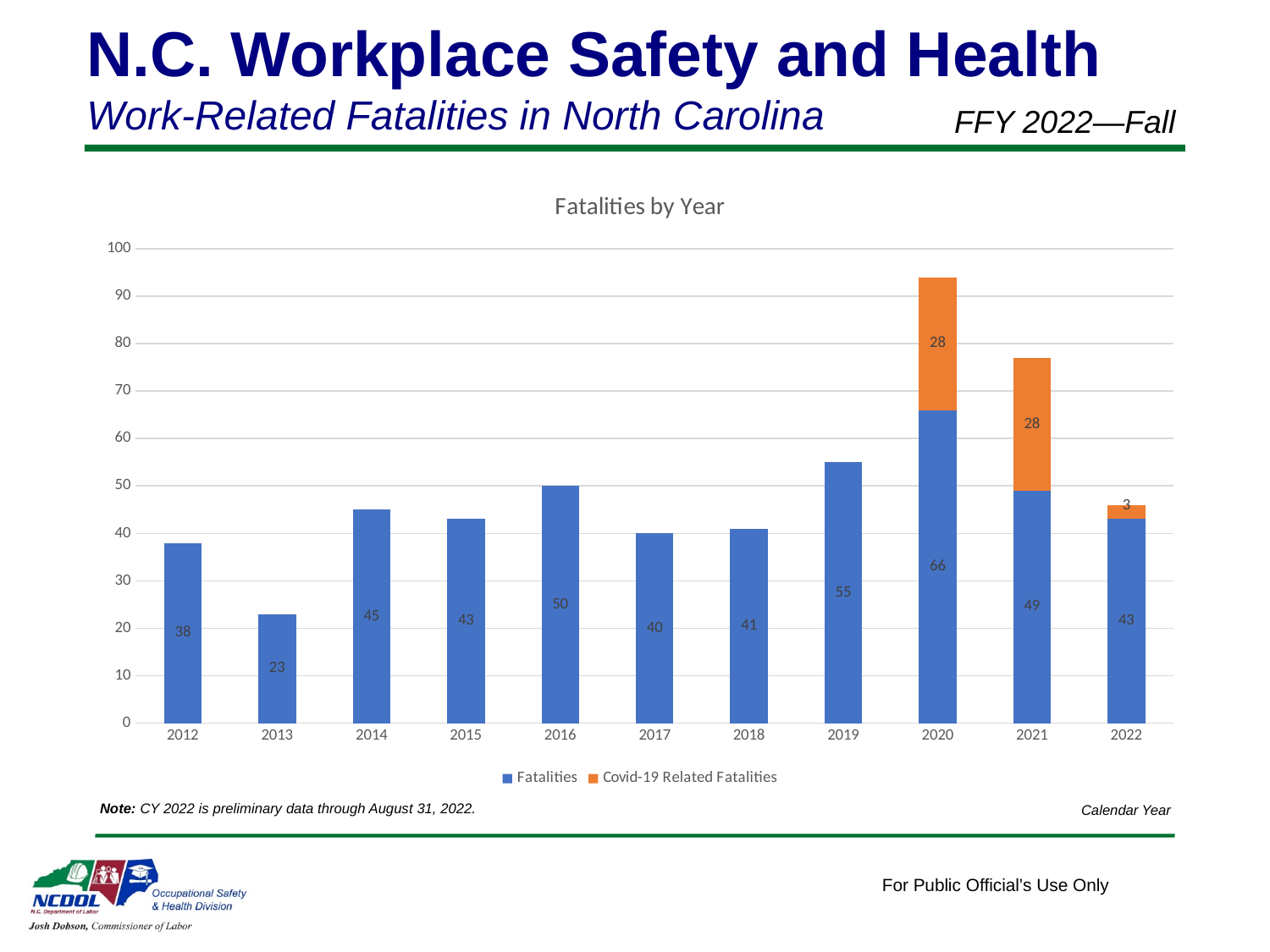
Which is larger, the Fatalities value for 2016 or for 2018? 2016 What type of chart is shown? Bar chart Which year has the highest Fatalities value? 2020 Which year has the lowest Fatalities value? 2013 How many series does the legend list? 2 What is the total of the stacked bar for 2021? 77 What is the value of Covid-19 Related Fatalities for 2020? 28 What is the total of the stacked bar for 2022? 46 What is the difference between the Fatalities values for 2020 and 2021? 17 How many years are shown on the x axis? 11 What is the value of Fatalities for 2019? 55 What is the value of Fatalities for 2013? 23